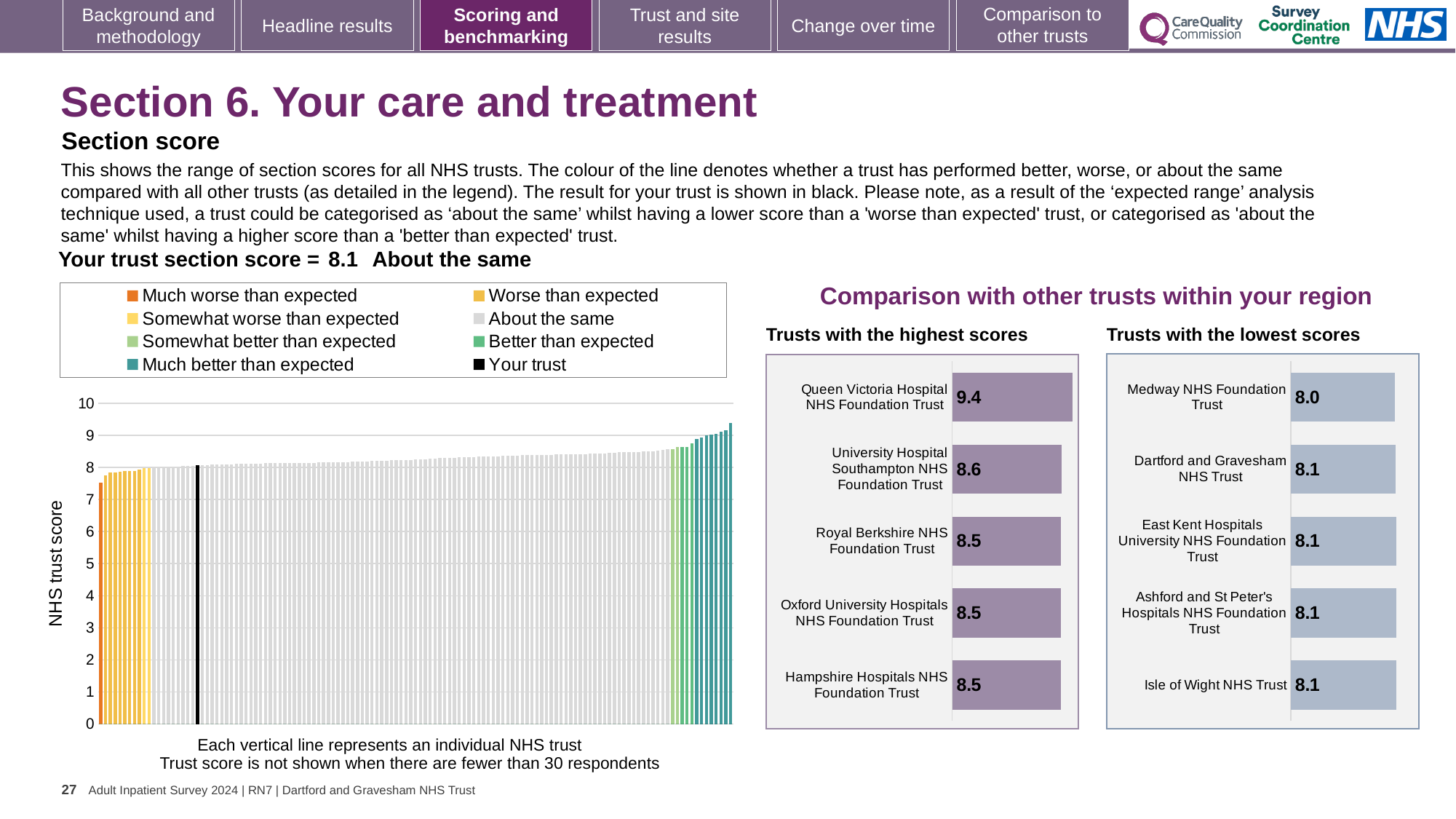
What kind of chart is the main chart showing the range of section scores for all NHS trusts? Bar chart In the 'Trusts with the highest scores' chart, what is the score for Queen Victoria Hospital NHS Foundation Trust? 9.4 In the 'Trusts with the highest scores' chart, what is the score for University Hospital Southampton NHS Foundation Trust? 8.6 In the main 'NHS trust score' chart, do the bar values rise or fall from left to right along the x axis? Rise In the 'Trusts with the highest scores' chart, what is the difference between the scores of Queen Victoria Hospital NHS Foundation Trust and Hampshire Hospitals NHS Foundation Trust? 0.9 In the 'Trusts with the lowest scores' chart, which trust has the lowest score? Medway NHS Foundation Trust In the main 'NHS trust score' chart, is the value for the black 'Your trust' bar greater or less than 5? greater In the 'Trusts with the lowest scores' chart, which has the larger score: Medway NHS Foundation Trust or Isle of Wight NHS Trust? Isle of Wight NHS Trust How many trusts are shown in the 'Trusts with the lowest scores' chart? 5 How many entries does the legend of the main 'NHS trust score' chart list? 8 In the 'Trusts with the lowest scores' chart, what is the score for Medway NHS Foundation Trust? 8.0 In the 'Trusts with the highest scores' chart, which trust has the highest score? Queen Victoria Hospital NHS Foundation Trust